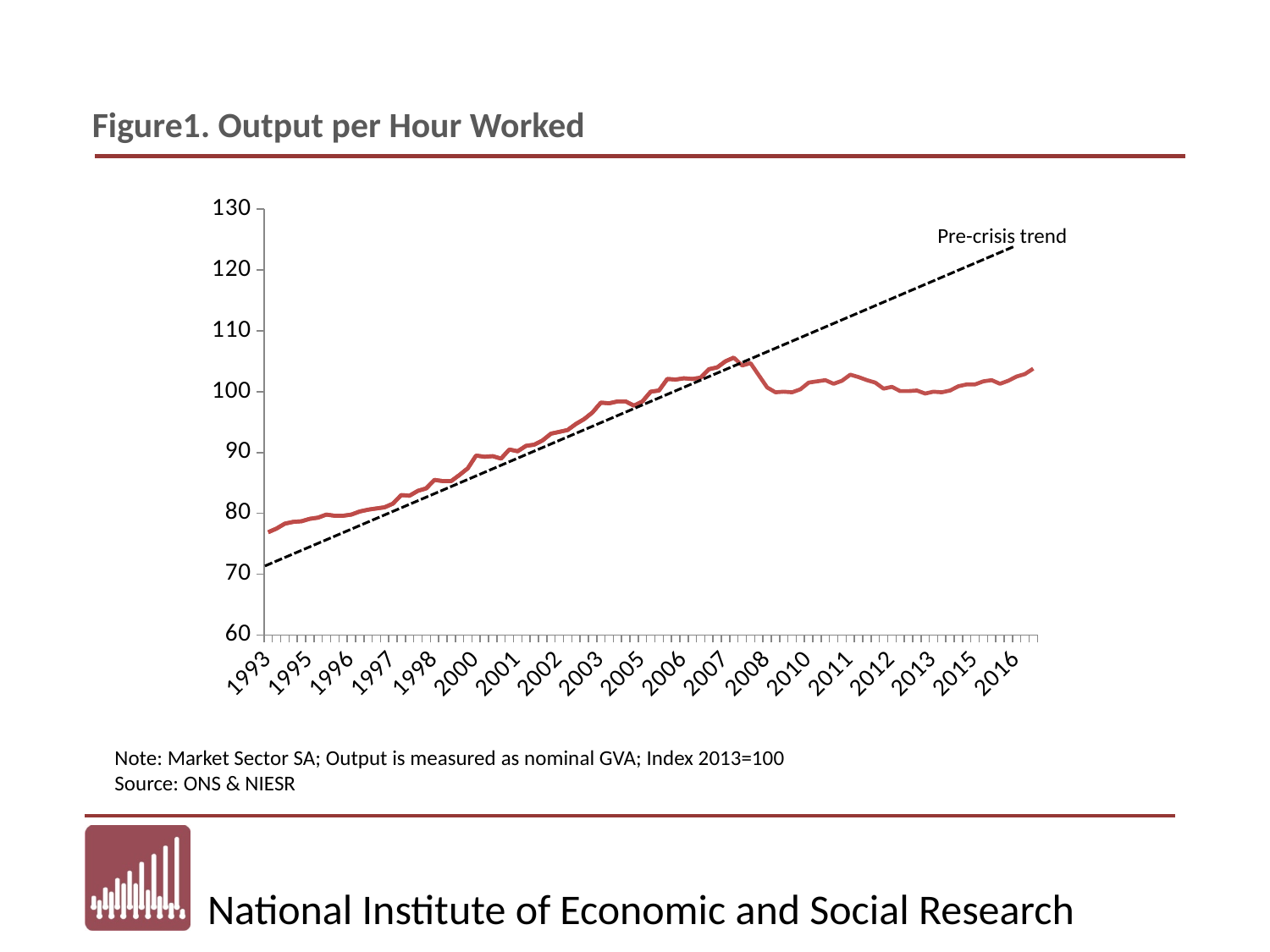
What is the title of the chart? Figure1. Output per Hour Worked Does the output per hour worked line rise or fall between 1993 and 2007? Rise Is the value of the output per hour worked line in 2016 greater or less than 100? greater At 2016, which is higher: the output per hour worked line or the pre-crisis trend line? Pre-crisis trend Is the value of the output per hour worked line in 2000 greater or less than 100? less At 1993, which is higher: the output per hour worked line or the pre-crisis trend line? Output per hour worked Is the value of the pre-crisis trend line at 2016 greater or less than 120? greater What label is given to the dashed line on the chart? Pre-crisis trend How many lines are plotted on the chart? 2 What kind of chart is shown on the slide? Line chart